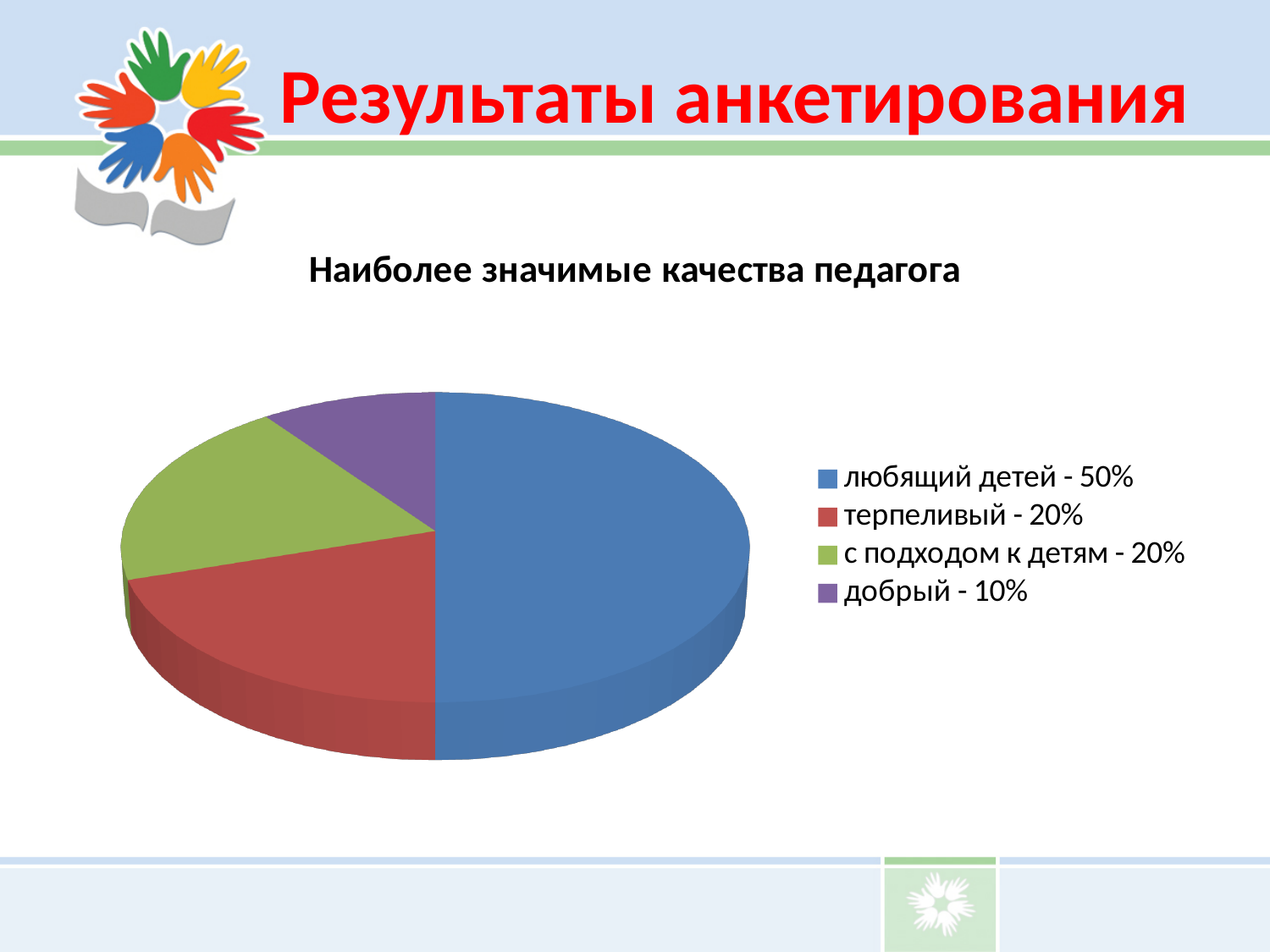
What share of the pie does 'добрый' have? 10% How many slices does the pie chart have? 4 What kind of chart is shown on the slide? pie chart What share of the pie does 'терпеливый' have? 20% Which category has the largest slice of the pie? любящий детей What share of the pie does 'любящий детей' have? 50% What is the difference in percentage points between 'любящий детей' and 'добрый'? 40% What colour is the slice for 'с подходом к детям'? green What is the combined share of 'терпеливый' and 'с подходом к детям'? 40% Which category has the smallest slice of the pie? добрый What is the title of the chart? Наиболее значимые качества педагога Which is larger, the slice for 'терпеливый' or the slice for 'добрый'? терпеливый